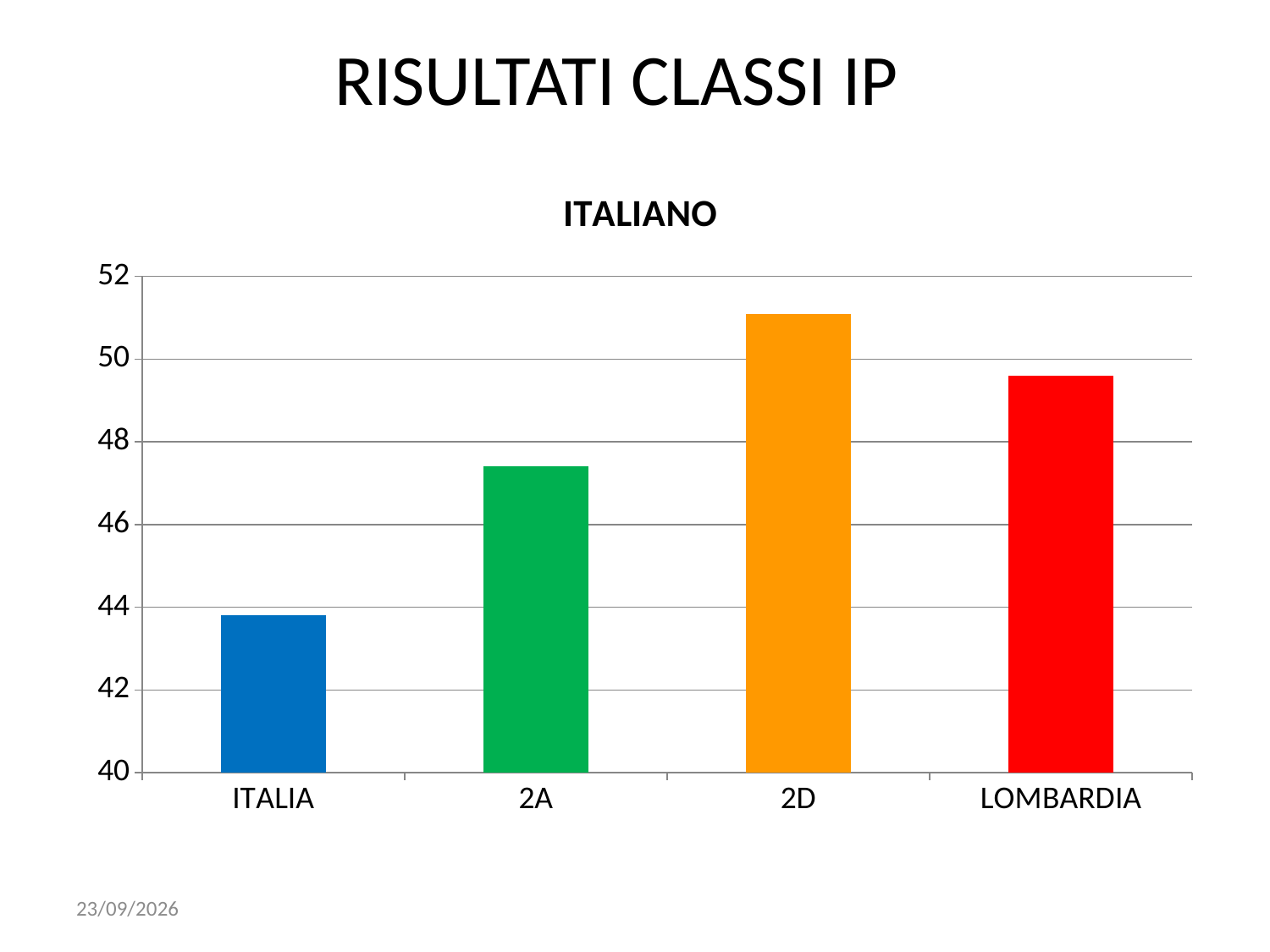
What is the title of the chart? ITALIANO Is the value for 2D greater or less than 50? greater What kind of chart is shown on the slide? bar chart How many categories are shown on the x axis? 4 Which is larger, the value for 2D or the value for ITALIA? 2D Which is larger, the value for 2A or the value for LOMBARDIA? LOMBARDIA Is the value for 2A greater or less than 48? less Which category has the highest value? 2D Which category has the lowest value? ITALIA What colour is the bar for 2D? orange